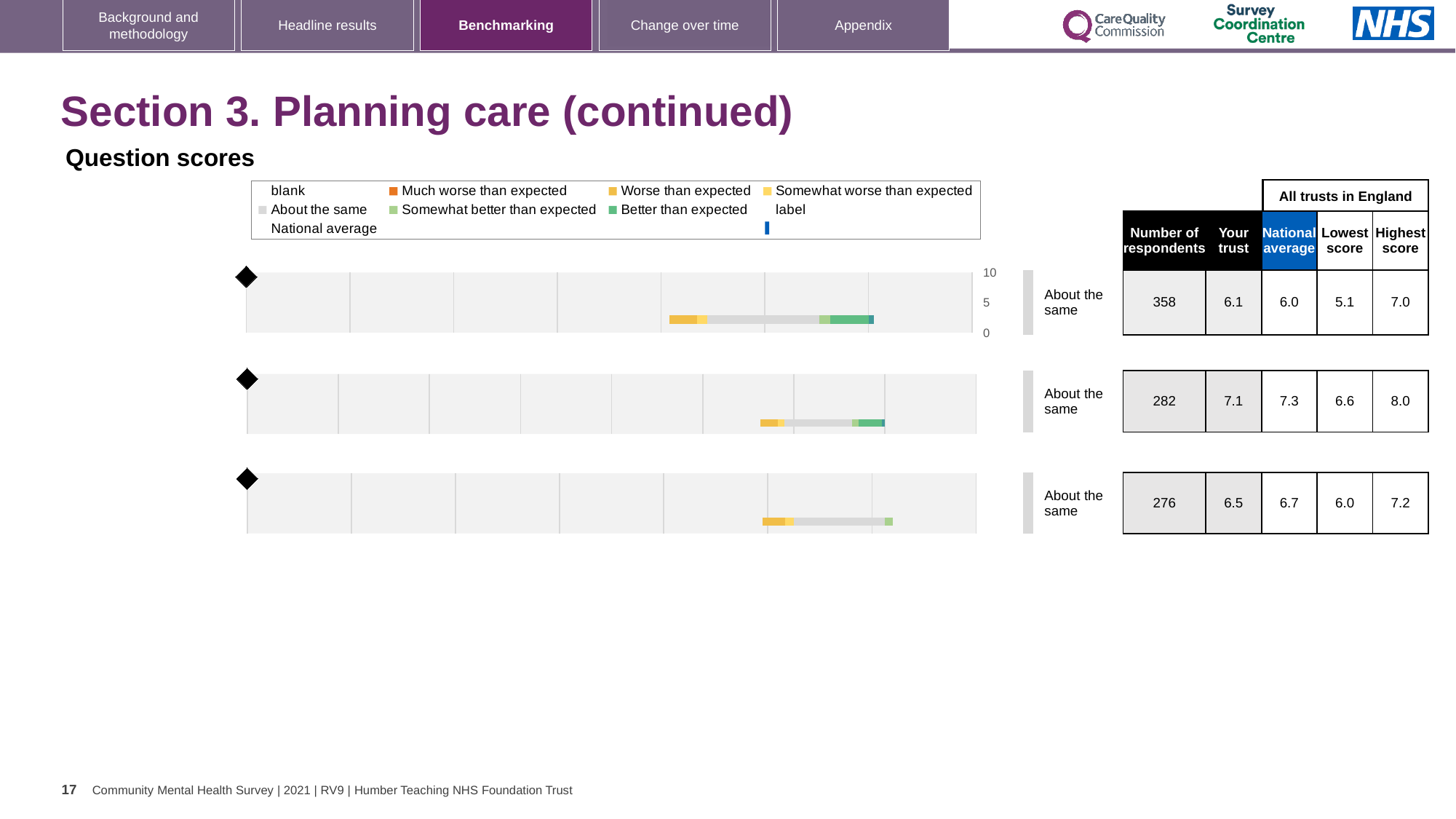
In the bottom chart row, what is the difference between the Highest score and the Lowest score? 1.2 In the second chart row, what is the National average score? 7.3 What is the maximum value shown on the score axis of the top chart? 10 What is the Highest score listed for the second chart row? 8.0 How many question score charts are shown on the slide? 3 In the top chart row, what is the 'Your trust' score shown in the table? 6.1 In the top chart row, is the 'Your trust' score higher or lower than the National average? higher How many respondents are listed for the third (bottom) chart row? 276 Which chart row has the highest 'Your trust' score? The second row (7.1) What kind of chart is used to show the question scores? Bar chart What benchmark category label is shown next to each of the three charts? About the same In the second chart row, what is the difference between the National average and the 'Your trust' score? 0.2